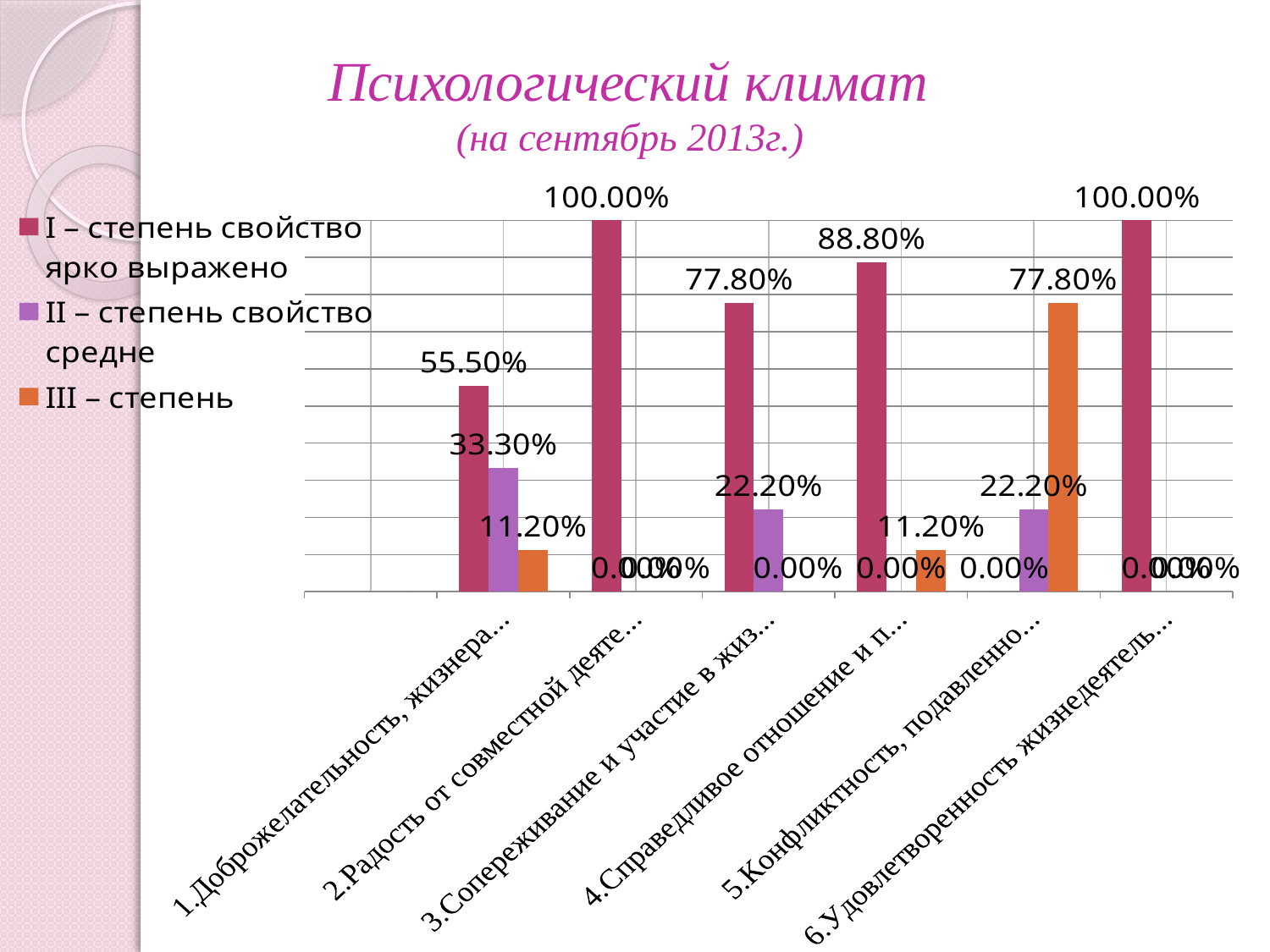
What is the difference between the 'I – степень' value for category 3 (Сопереживание) and the 'II – степень' value for the same category? 55.60% Which category has the highest value for the 'III – степень' series? 5.Конфликтность What is the value of the 'I – степень свойство ярко выражено' series for category 4 (Справедливое отношение)? 88.80% What type of chart is shown on the slide? bar chart How many series does the legend list? 3 What is the value of the 'II – степень свойство средне' series for category 1 (Доброжелательность)? 33.30% How many categories are shown on the x axis? 6 What is the value of the 'III – степень' series for category 5 (Конфликтность)? 77.80% What is the value of the 'I – степень свойство ярко выражено' series for category 1 (Доброжелательность)? 55.50% Which is larger for category 1 (Доброжелательность): the 'II – степень свойство средне' value or the 'III – степень' value? II – степень свойство средне Which category has the lowest value for the 'I – степень свойство ярко выражено' series? 5.Конфликтность What is the title of the chart on the slide? Психологический климат (на сентябрь 2013г.)